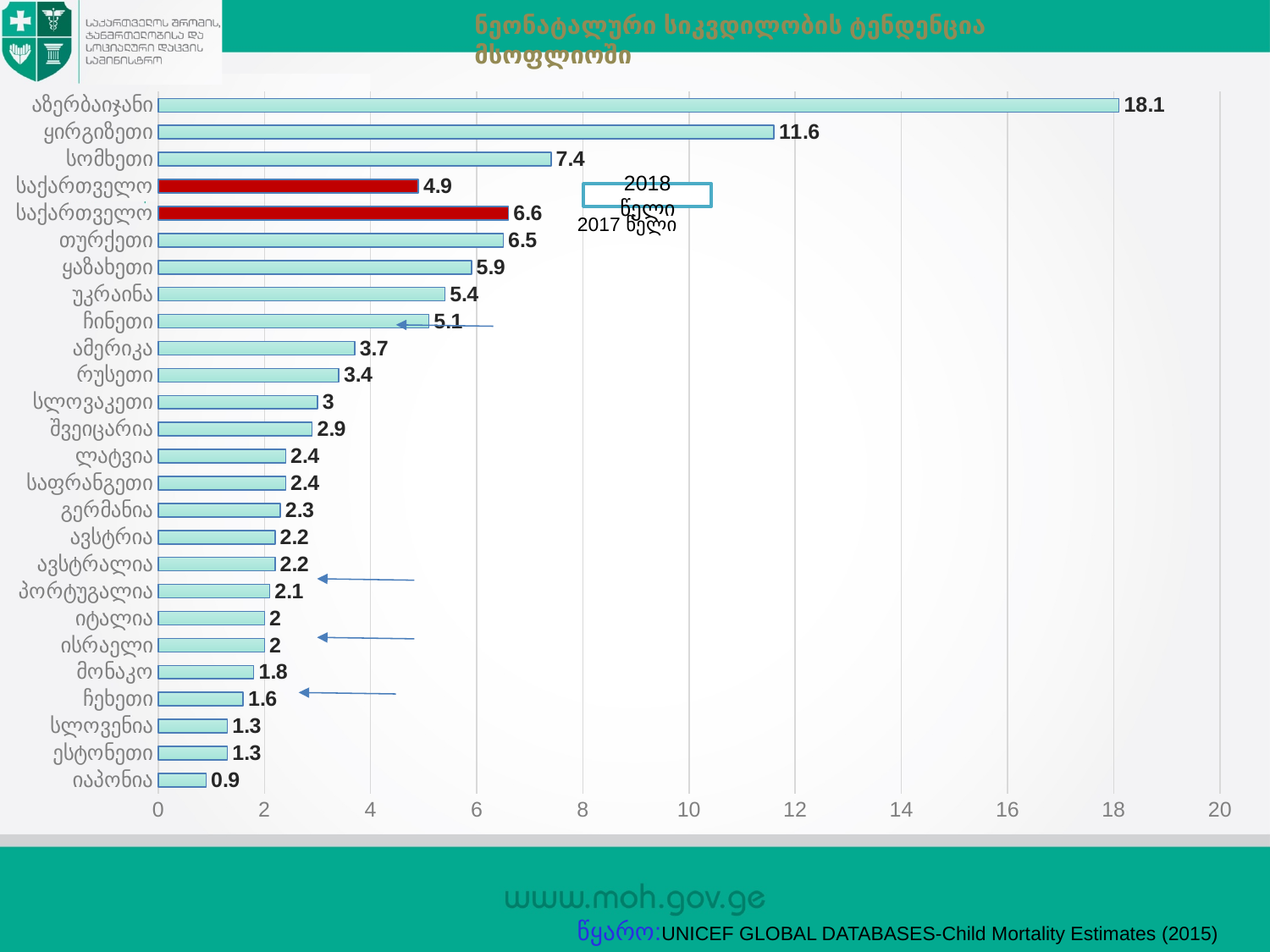
Which category has the lowest value? იაპონია What is the value for ყირგიზეთი? 11.6 Which category has the highest value? აზერბაიჯანი What is the value for თურქეთი? 6.5 Which two bars are highlighted in red? the two საქართველო bars What is the value for იაპონია? 0.9 Which is larger, the value for ყაზახეთი or the value for უკრაინა? ყაზახეთი What is the difference between the value for აზერბაიჯანი and the value for ყირგიზეთი? 6.5 What kind of chart is shown on the slide? bar chart What is the value for აზერბაიჯანი? 18.1 How many bars are plotted in the chart? 26 What is the difference between the 2017 value for საქართველო (6.6) and the 2018 value for საქართველო (4.9)? 1.7